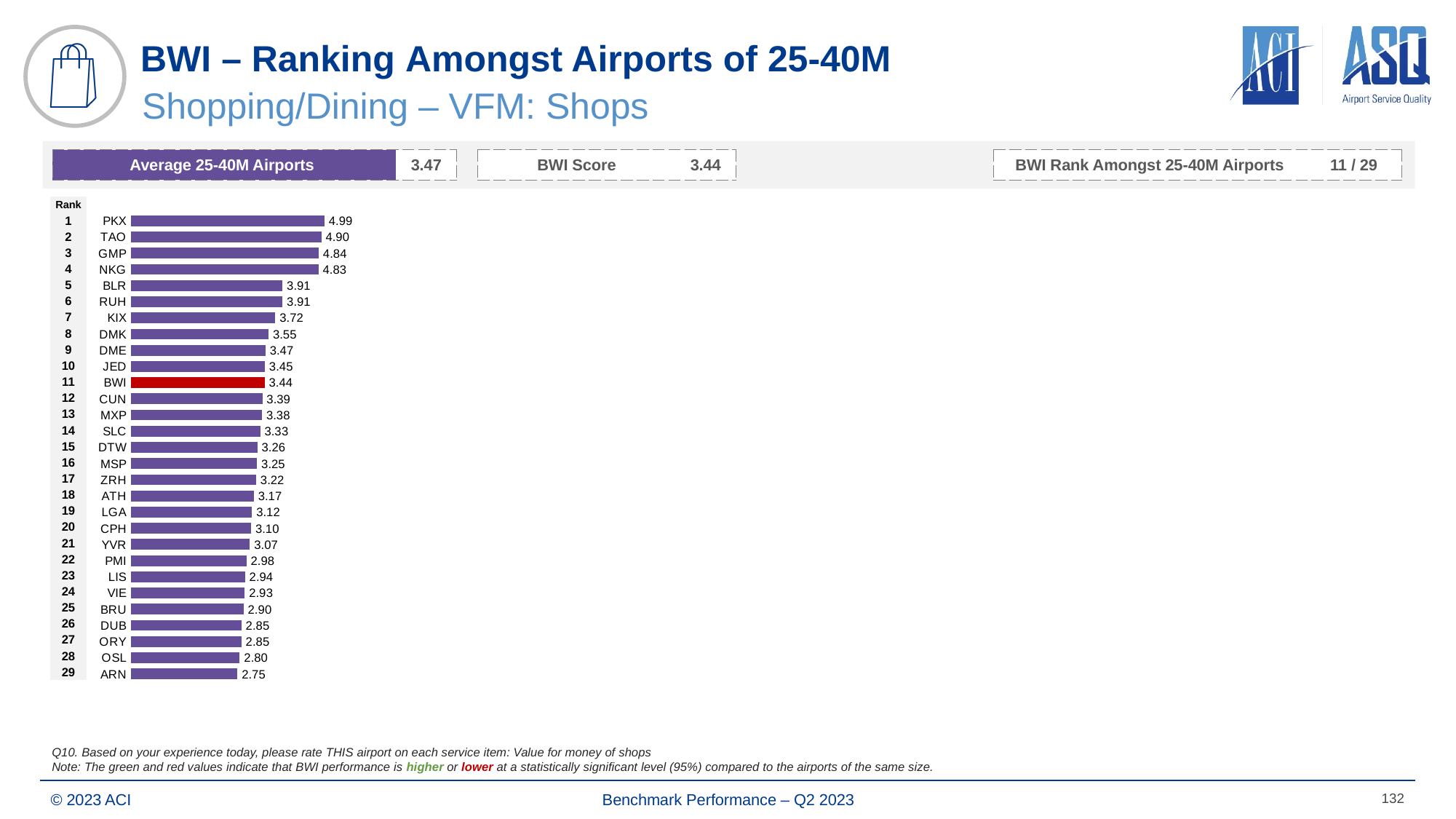
How many airports are ranked in the chart? 29 What is the value for PKX in the chart? 4.99 Which airport has the highest value in the chart? PKX What is the difference between the values for PKX and BWI? 1.55 Which has a larger value, KIX or DMK? KIX Do the values rise or fall going down the ranking from rank 1 to rank 29? fall What is the value for BWI in the chart? 3.44 Which bar in the chart is coloured red? BWI What is the value for ARN in the chart? 2.75 Which airport has the lowest value in the chart? ARN What kind of chart is shown on the slide? bar chart What is the value for DME in the chart? 3.47